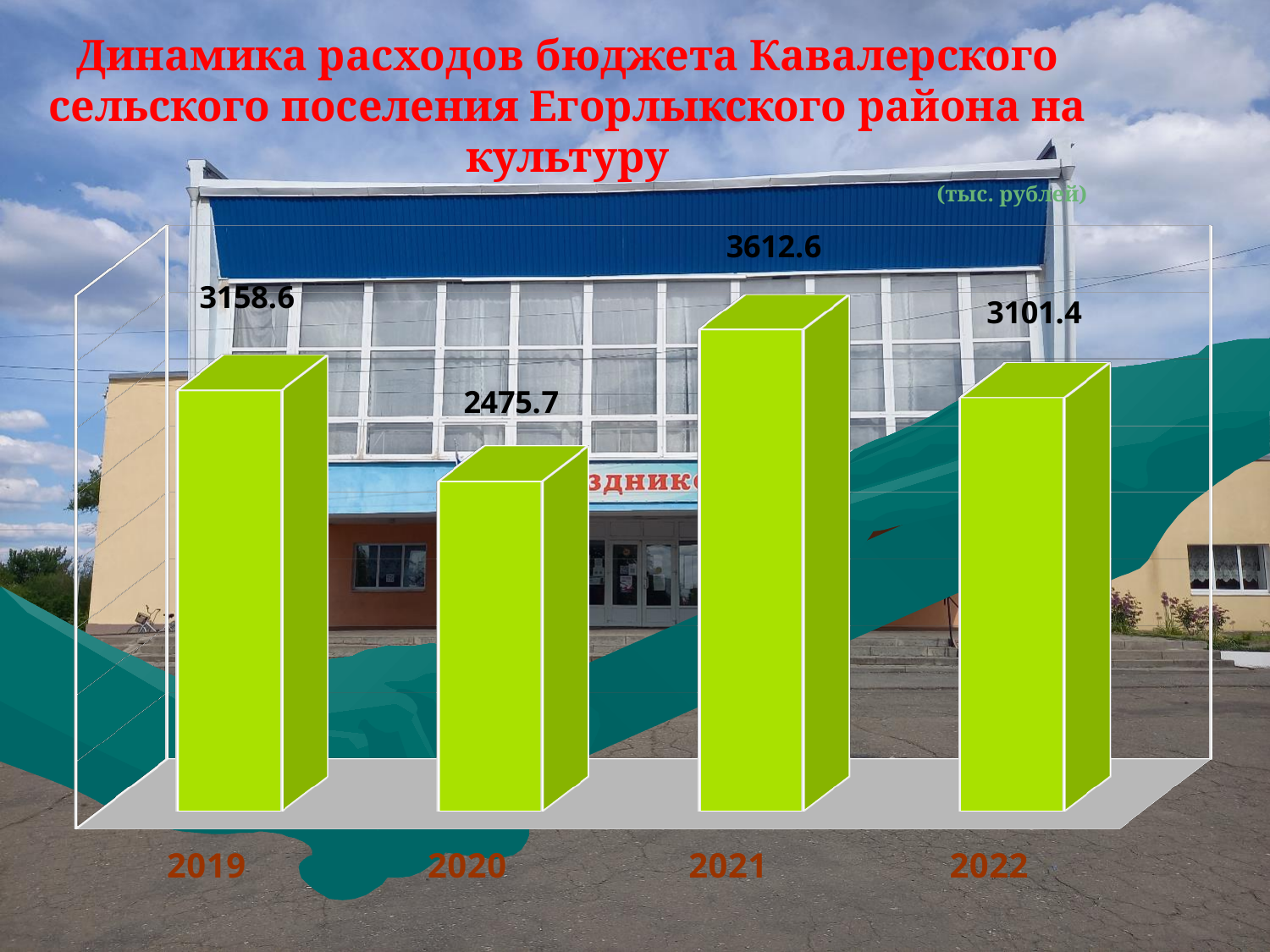
What is the value for 2019? 3158.6 What is the value for 2022? 3101.4 What is the value for 2021? 3612.6 What is the value for 2020? 2475.7 What is the difference between the values for 2021 and 2020? 1136.9 Which is larger, the value for 2019 or the value for 2020? 2019 Which year has the lowest value? 2020 How many years are shown on the chart? 4 In what units are the values given, according to the label under the title? тыс. рублей Which year has the highest value? 2021 What is the difference between the values for 2019 and 2022? 57.2 What kind of chart is this? bar chart